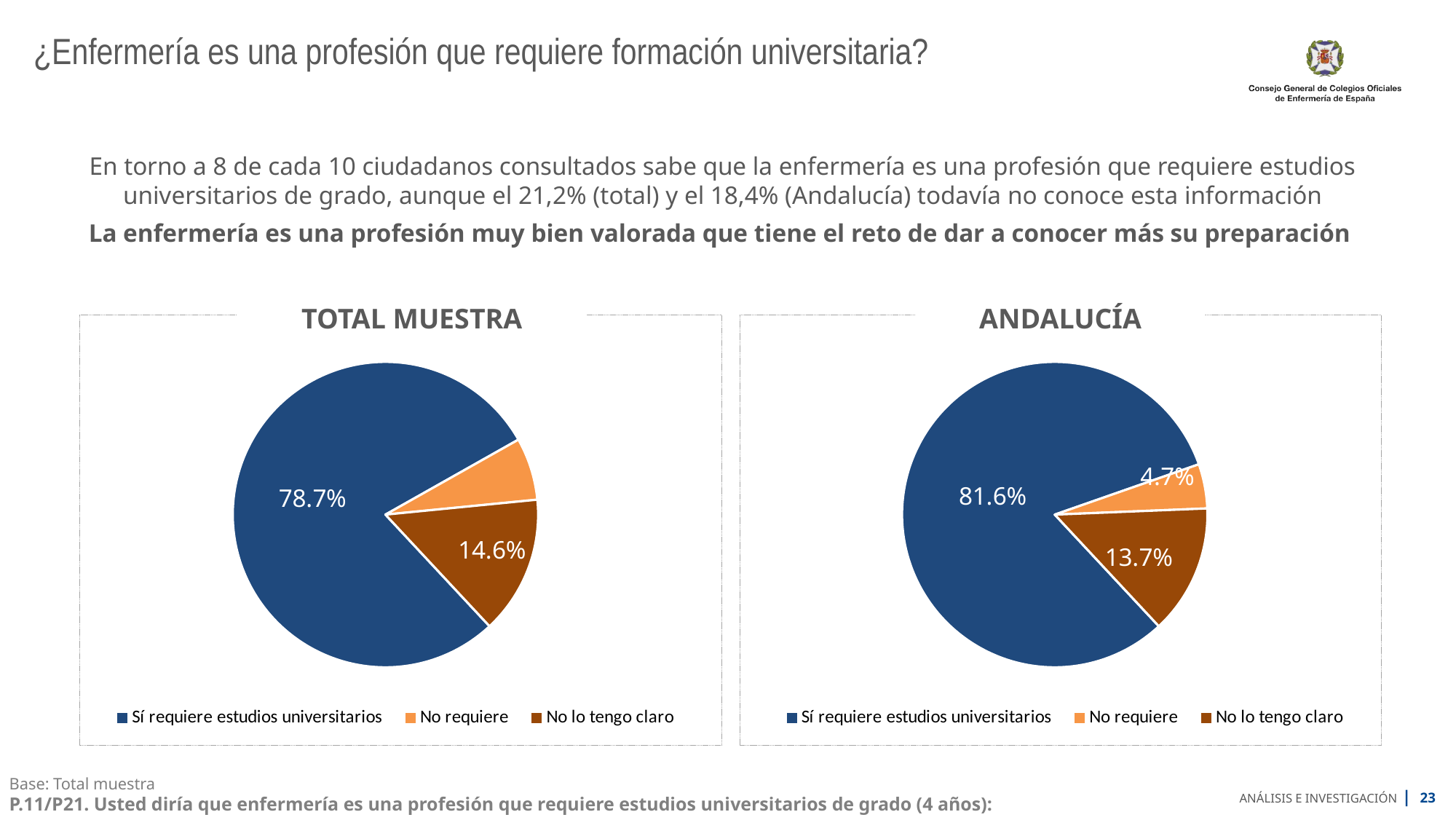
In the ANDALUCÍA chart, what is the difference between the "Sí requiere estudios universitarios" share and the "No lo tengo claro" share? 67.9% In the TOTAL MUESTRA chart, what share of respondents answered "No lo tengo claro"? 14.6% In the TOTAL MUESTRA chart, what colour is the "No lo tengo claro" slice? Brown In the ANDALUCÍA chart, which category has the smallest slice? No requiere Which chart shows a larger share for "Sí requiere estudios universitarios", TOTAL MUESTRA or ANDALUCÍA? ANDALUCÍA How many categories does the legend of the TOTAL MUESTRA chart list? 3 In the ANDALUCÍA chart, what share of respondents answered "No requiere"? 4.7% In the TOTAL MUESTRA chart, what share of respondents answered "Sí requiere estudios universitarios"? 78.7% In the TOTAL MUESTRA chart, which category has the largest slice? Sí requiere estudios universitarios What type of chart is used for ANDALUCÍA? Pie chart In the ANDALUCÍA chart, what share of respondents answered "Sí requiere estudios universitarios"? 81.6% In the ANDALUCÍA chart, what share of respondents answered "No lo tengo claro"? 13.7%